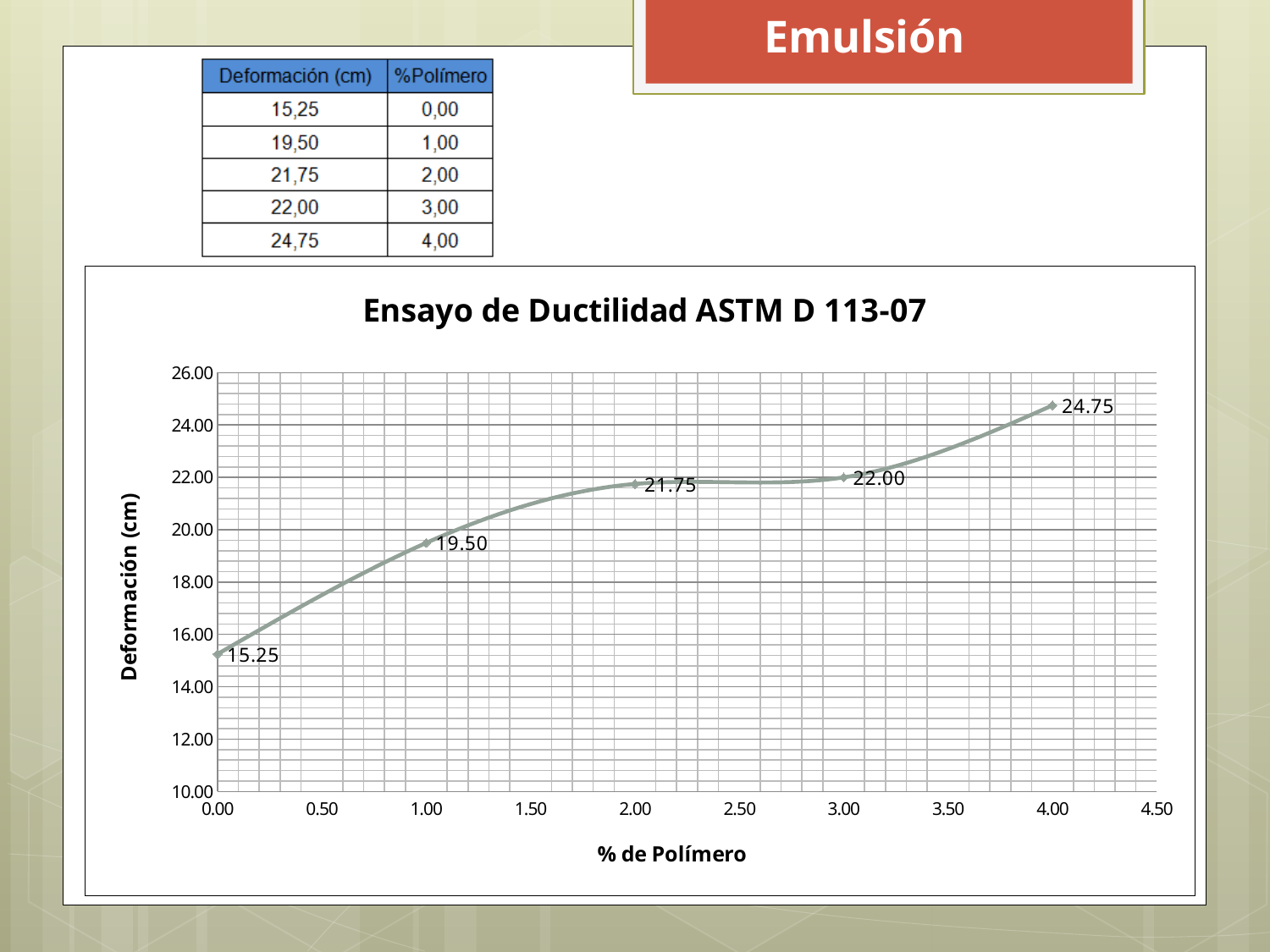
At which % de Polímero is the Deformación lowest? 0.00 What is the difference in Deformación between 4.00 and 0.00 % de Polímero? 9.50 How many data points are plotted on the chart? 5 Which has a larger Deformación value: 1.00 or 3.00 % de Polímero? 3.00 Does the Deformación rise or fall as % de Polímero increases? rise What is the Deformación (cm) value at 2.00 % de Polímero? 21.75 At which % de Polímero is the Deformación highest? 4.00 What is the Deformación (cm) value at 1.00 % de Polímero? 19.50 What is the title of the chart? Ensayo de Ductilidad ASTM D 113-07 What is the Deformación (cm) value at 0.00 % de Polímero? 15.25 What kind of chart is shown on the slide? line chart What is the Deformación (cm) value at 4.00 % de Polímero? 24.75